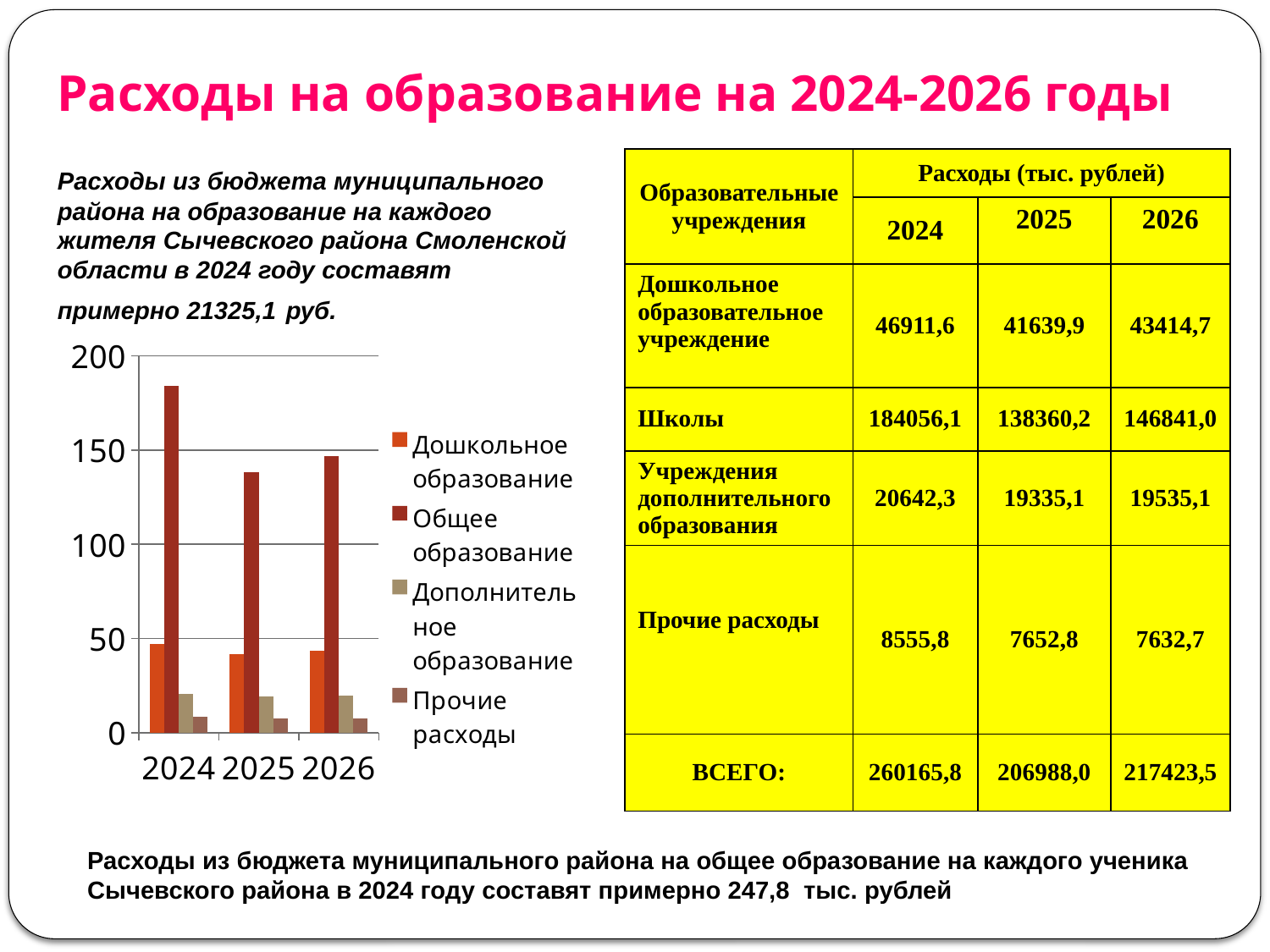
What kind of chart is shown on the slide? bar chart Which series has the smallest bar in 2024? Прочие расходы Does the value for Общее образование rise or fall from 2024 to 2025? fall Is the value for Дошкольное образование in 2024 greater or less than 100? less In which year is the bar for Общее образование the lowest? 2025 How many series does the chart legend list? 4 Which series is shown in dark red in the chart legend? Общее образование In which year is the bar for Общее образование the highest? 2024 Is the value for Общее образование in 2024 greater or less than 150? greater Which is larger: Общее образование in 2026 or Общее образование in 2025? 2026 Is the value for Общее образование in 2025 greater or less than 150? less How many years are shown on the x axis of the chart? 3